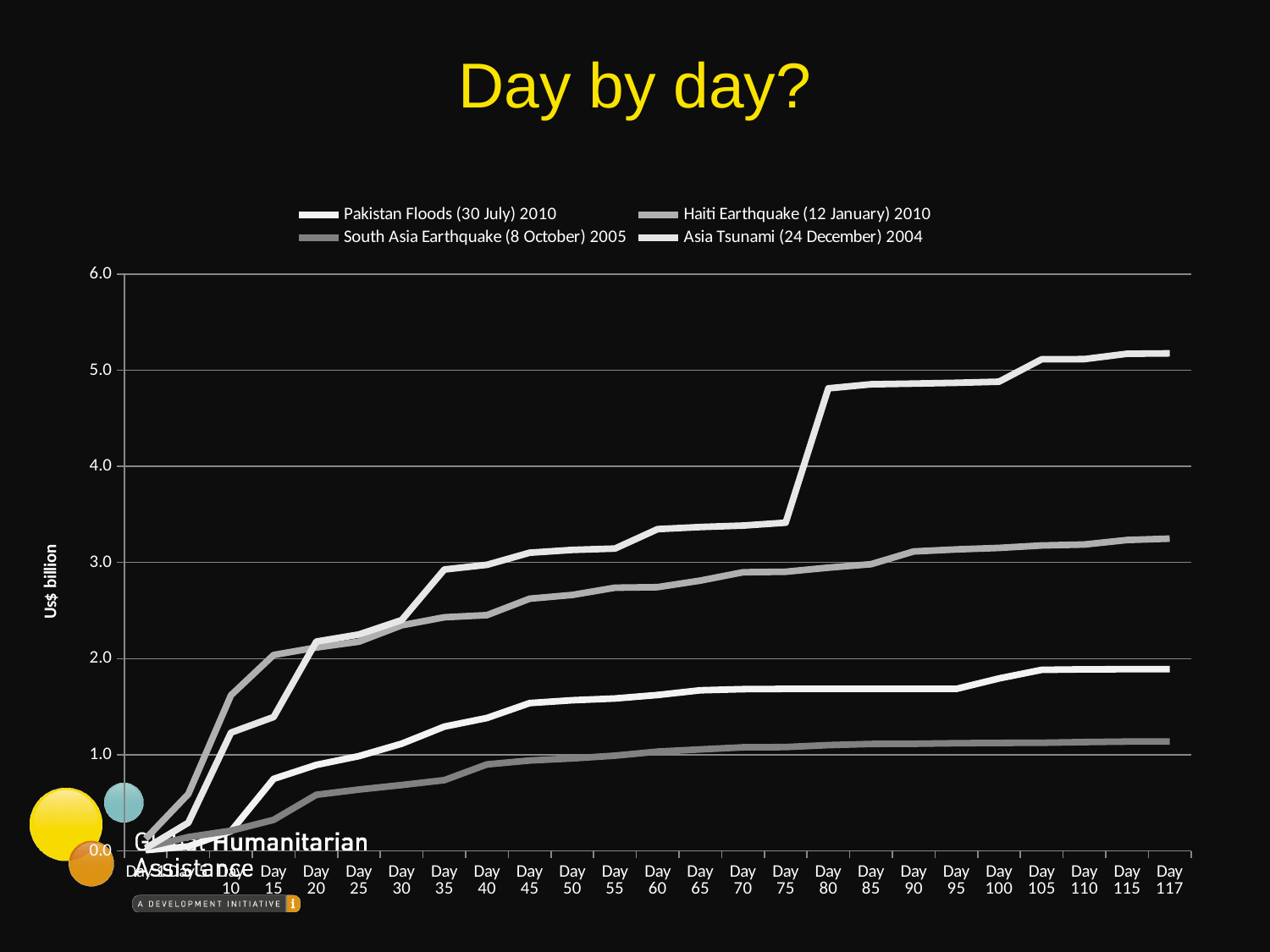
What is the label on the vertical axis? Us$ billion Is the value of the topmost line at Day 117 greater or less than 5.0? greater What is the highest value shown on the vertical axis? 6.0 Do the lines generally rise or fall as the days increase along the x axis? rise What type of chart is shown on the slide? line chart What is the last day label shown on the x axis? Day 117 What is the title of the slide? Day by day? Is the value of the lowest line at Day 117 greater or less than 1.0? greater Is the value of the lowest line at Day 117 greater or less than 2.0? less How many series does the legend list? 4